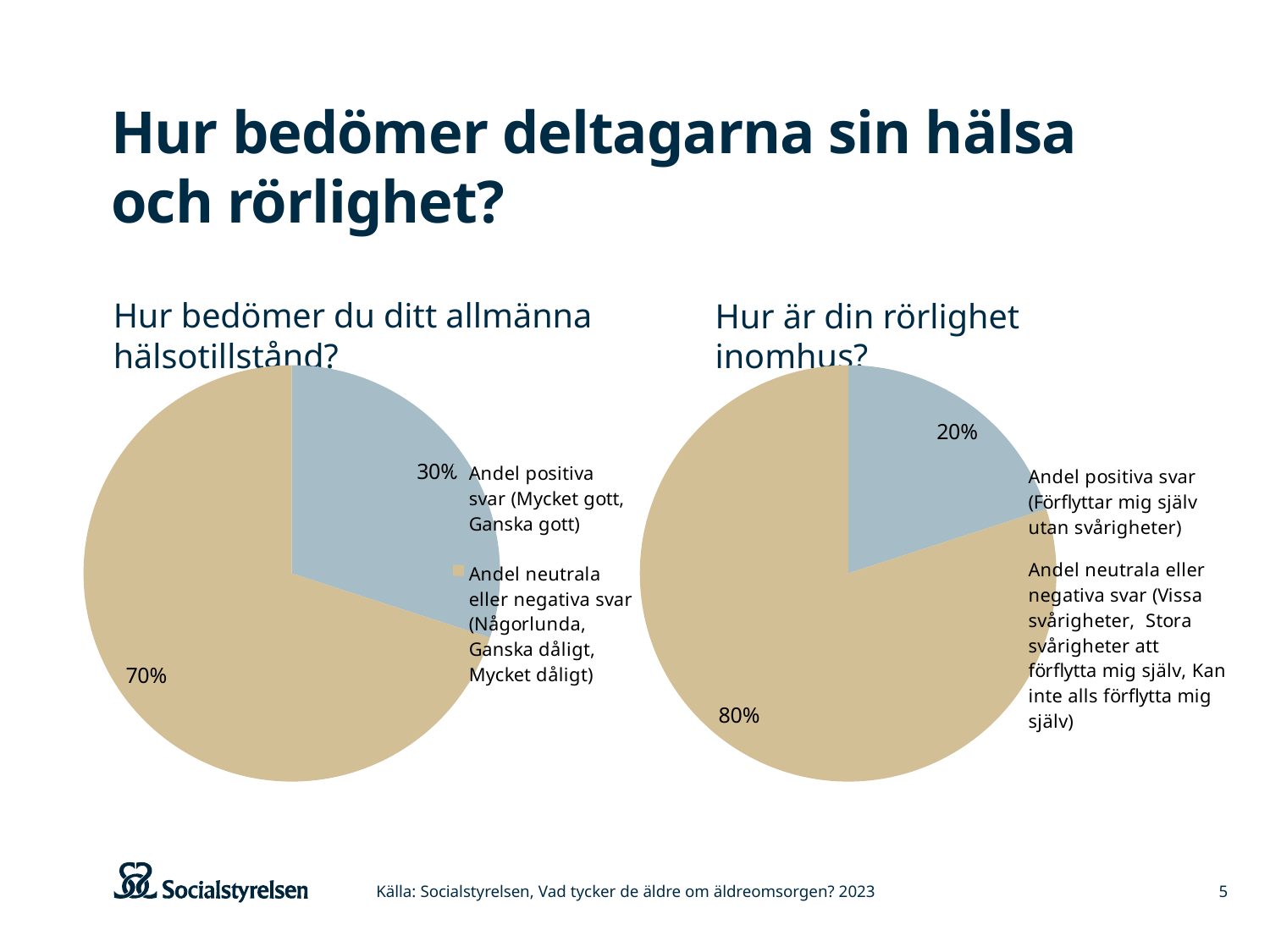
Which chart has the larger share of positive answers, the left chart on general health or the right chart on indoor mobility? The left chart (Hur bedömer du ditt allmänna hälsotillstånd?) In the left chart 'Hur bedömer du ditt allmänna hälsotillstånd?', which category has the largest slice? Andel neutrala eller negativa svar In the right chart 'Hur är din rörlighet inomhus?', what share of answers are positive (Andel positiva svar)? 20% In the left chart 'Hur bedömer du ditt allmänna hälsotillstånd?', what is the difference between the neutral/negative share and the positive share? 40 percentage points In the right chart 'Hur är din rörlighet inomhus?', which category has the smallest slice? Andel positiva svar In the right chart 'Hur är din rörlighet inomhus?', what is the difference between the neutral/negative share and the positive share? 60 percentage points In the right chart 'Hur är din rörlighet inomhus?', what share of answers are neutral or negative? 80% In the left chart 'Hur bedömer du ditt allmänna hälsotillstånd?', what share of answers are positive (Andel positiva svar)? 30% What type of chart is used for 'Hur är din rörlighet inomhus?'? Pie chart How many slices does the left chart 'Hur bedömer du ditt allmänna hälsotillstånd?' have? 2 In the right chart 'Hur är din rörlighet inomhus?', which colour represents the positive answers (Andel positiva svar)? Blue In the left chart 'Hur bedömer du ditt allmänna hälsotillstånd?', what share of answers are neutral or negative (Andel neutrala eller negativa svar)? 70%